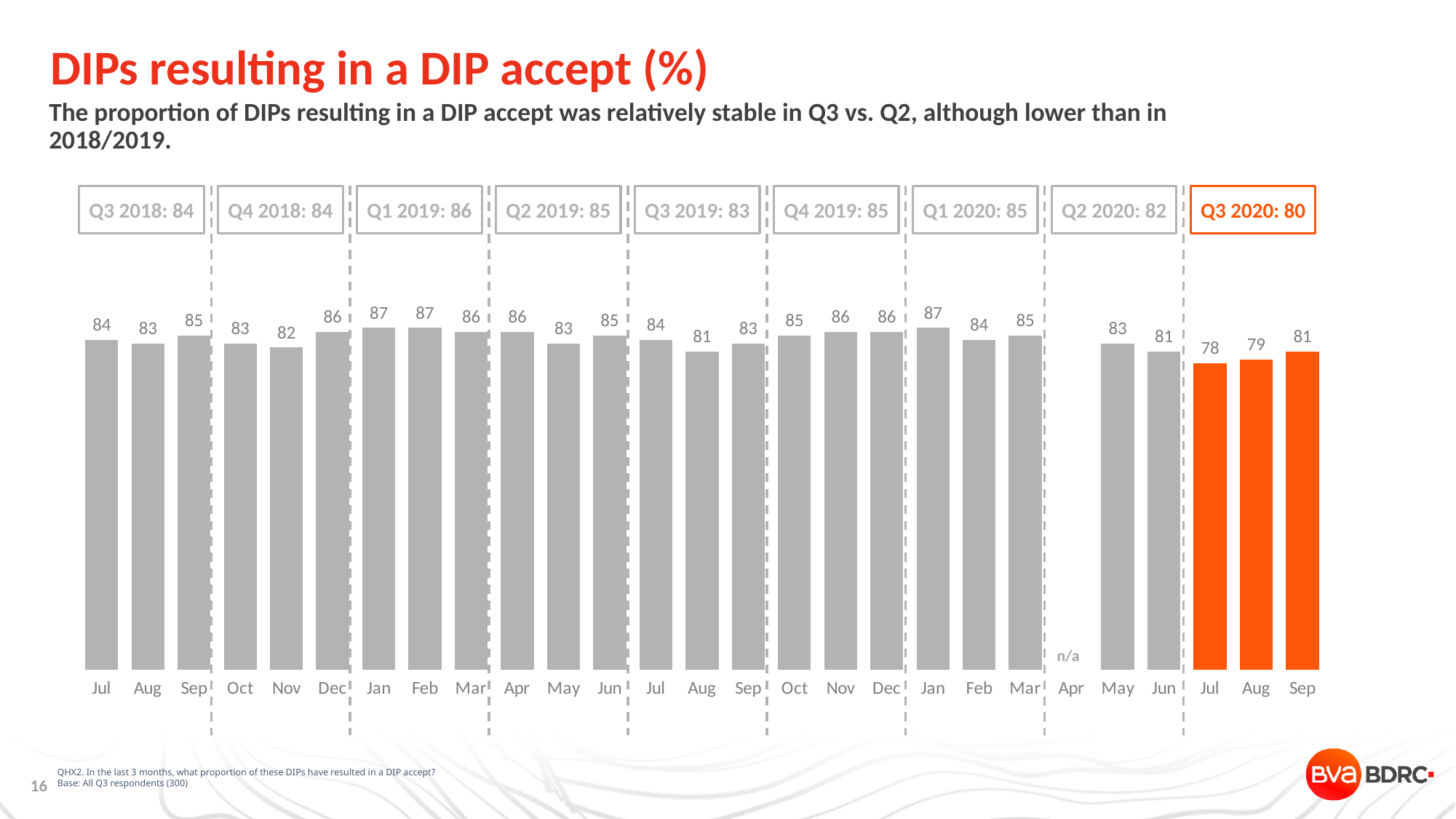
How many quarterly summary boxes are shown above the chart? 9 Which month in the chart is marked as n/a instead of having a bar? Apr (Q2 2020) What kind of chart is shown on the slide? bar chart Which quarter's bars are highlighted in orange on the chart? Q3 2020 What is the value for Nov in the Q4 2018 section of the chart? 82 What is the value for Sep in the Q3 2020 section of the chart? 81 What is the highest monthly value shown on the chart? 87 What is the difference between the Q1 2019 quarterly figure (86) and the Q3 2020 quarterly figure (80)? 6 Which month has the lowest value on the chart? Jul (Q3 2020) What is the value for Jul in the Q3 2020 section of the chart? 78 Which is larger: the value for Aug in Q3 2019 or the value for Aug in Q3 2020? Aug in Q3 2019 What is the quarterly figure shown in the box for Q1 2019? 86